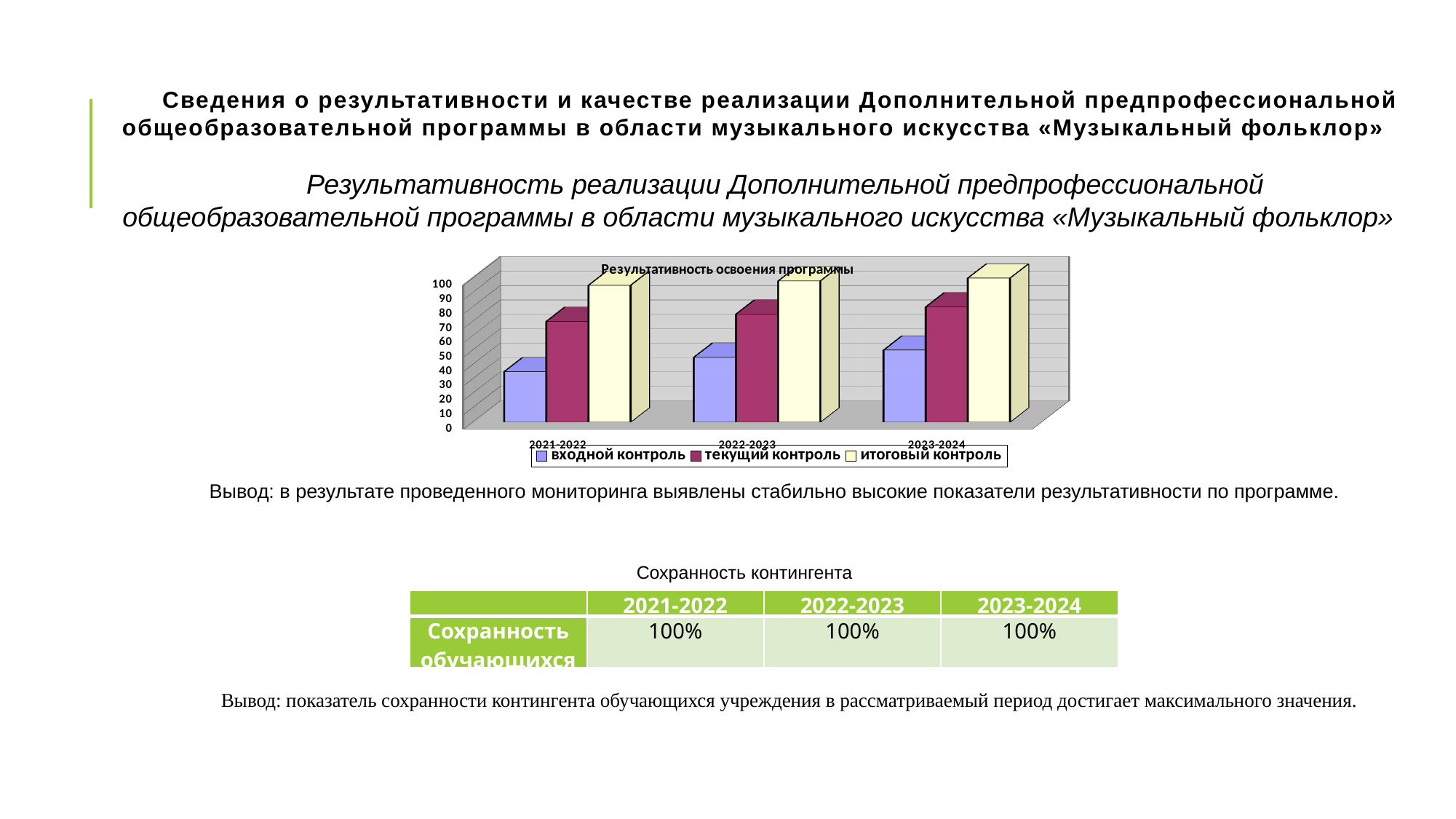
Do the values for входной контроль rise or fall from 2021-2022 to 2023-2024? rise How many categories (academic years) are shown on the x axis of the chart? 3 Is the value for итоговый контроль in 2022-2023 greater or less than 80? greater Is the value for текущий контроль in 2021-2022 greater or less than 50? greater How many series does the chart legend list? 3 What kind of chart is shown on the slide? bar chart What is the title of the chart? Результативность освоения программы Is the value for входной контроль in 2021-2022 greater or less than 60? less Which series is shown in yellow in the chart? итоговый контроль In 2021-2022, which is larger: входной контроль or текущий контроль? текущий контроль For the series входной контроль, which academic year has the lowest value? 2021-2022